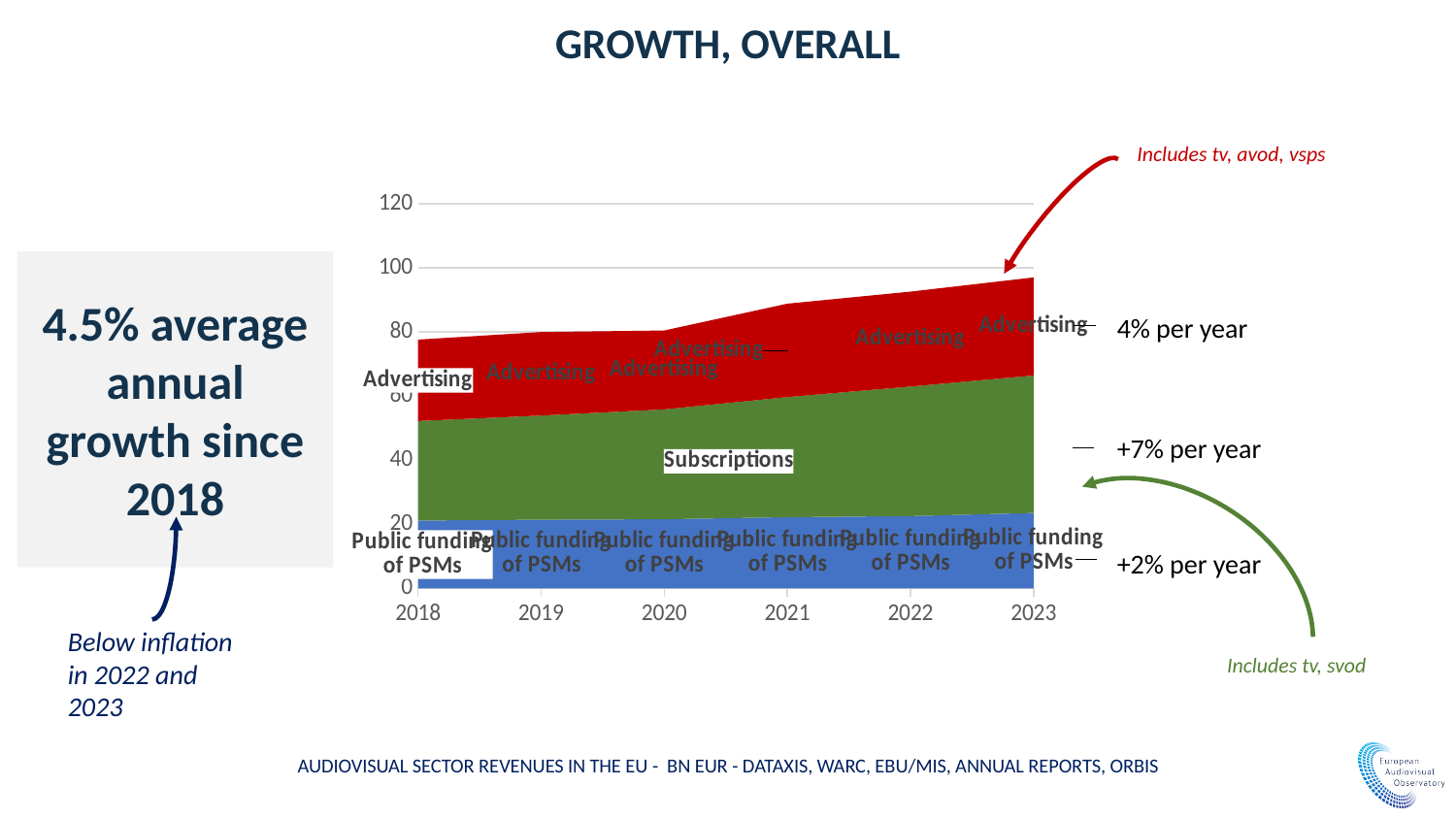
Is the total revenue in 2023 greater or less than 100? less What is the annual growth rate shown for Advertising? 4% per year Which series is the smallest in 2023? Public funding of PSMs What is the annual growth rate shown for Public funding of PSMs? +2% per year Which series has the highest annual growth rate according to the annotations? Subscriptions What kind of chart is shown on the slide? Stacked area chart How many years are shown on the x axis of the chart? 6 What is the title of the chart slide? GROWTH, OVERALL Is the total revenue in 2023 greater or less than 80? greater What is the annual growth rate shown for Subscriptions? +7% per year How many revenue series are stacked in the chart? 3 Does total revenue rise or fall from 2018 to 2023? rise